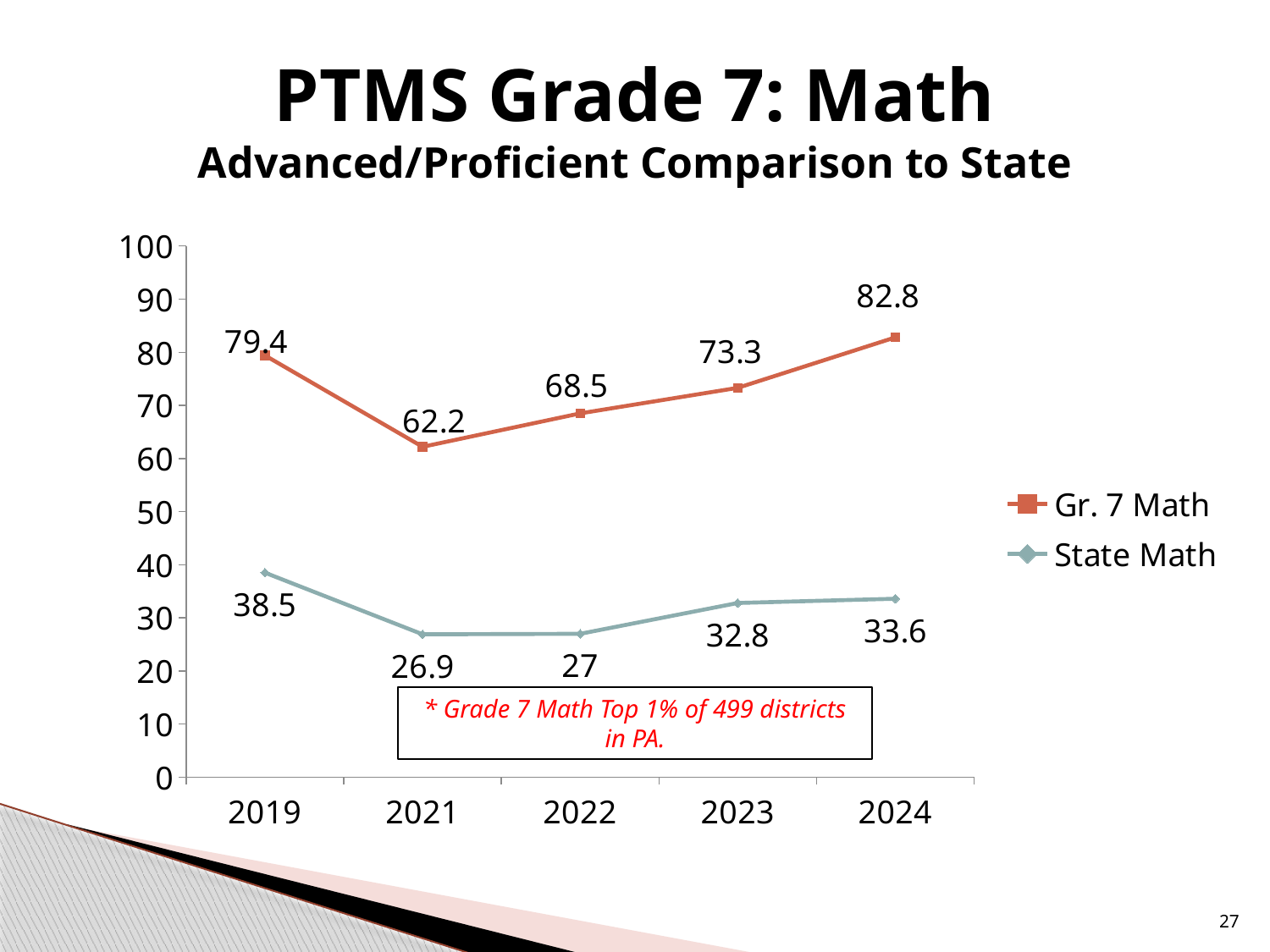
What is the difference between the Gr. 7 Math and State Math values in 2023? 40.5 What kind of chart is shown on the slide? line chart How many series does the legend list? 2 What is the Gr. 7 Math value for 2024? 82.8 In which year is the State Math value highest? 2019 Which is larger: the Gr. 7 Math value in 2019 or in 2024? 2024 In which year is the Gr. 7 Math value lowest? 2021 Is the State Math value for 2024 greater or less than 40? less What is the Gr. 7 Math value for 2022? 68.5 How many years are shown on the x axis? 5 What is the State Math value for 2021? 26.9 Does the Gr. 7 Math value rise or fall from 2021 to 2024? rise